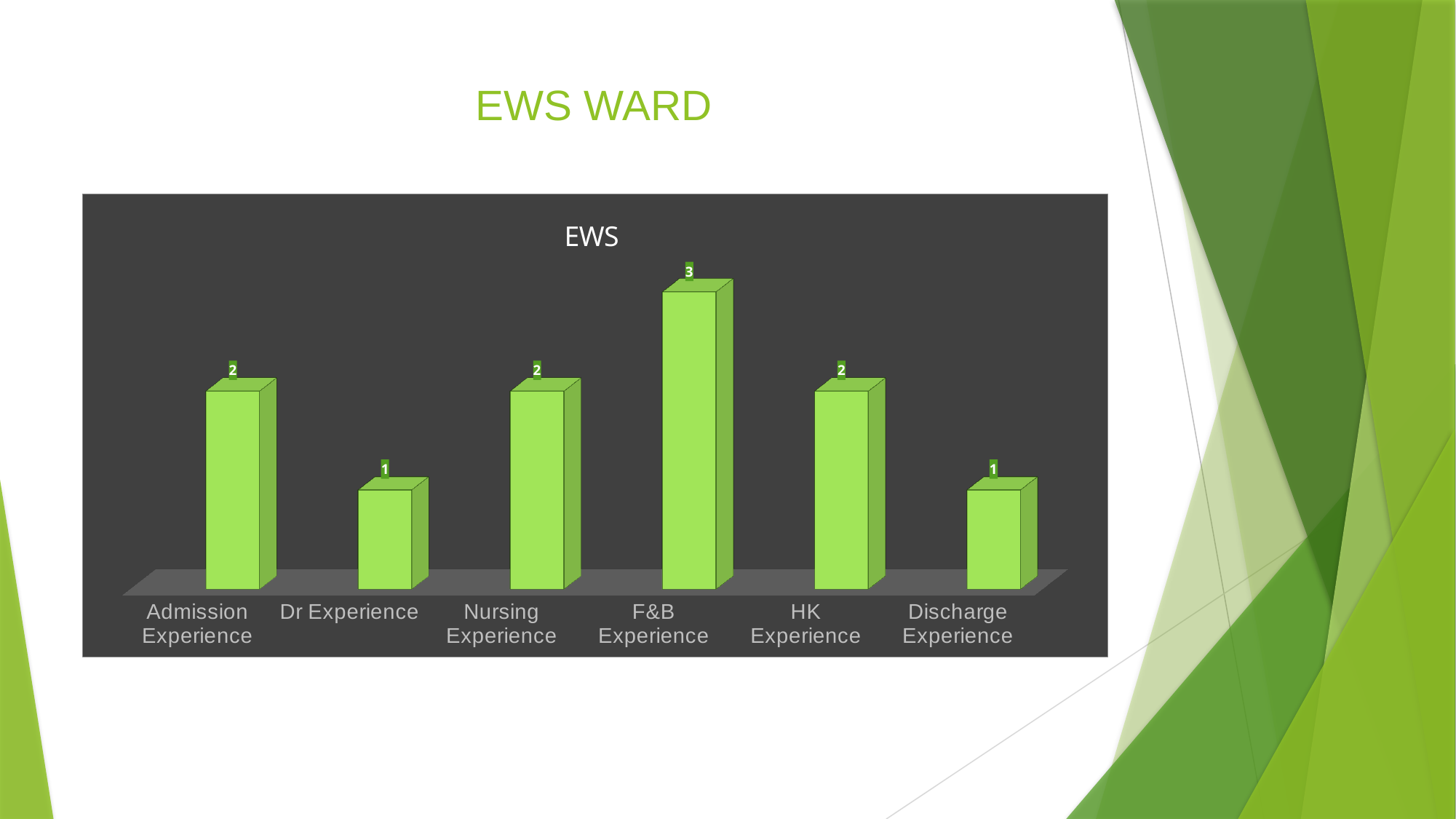
Which category has the highest value? F&B Experience What is the difference between the values for Nursing Experience and Discharge Experience? 1 What is the value for Discharge Experience? 1 What kind of chart is shown on the slide? Bar chart What is the value for Dr Experience? 1 How many categories are shown on the chart? 6 What is the value for Admission Experience? 2 Which is larger, the value for HK Experience or the value for Discharge Experience? HK Experience What is the value for F&B Experience? 3 What is the title of the chart? EWS What is the difference between the values for F&B Experience and Dr Experience? 2 Which is larger, the value for F&B Experience or the value for Admission Experience? F&B Experience